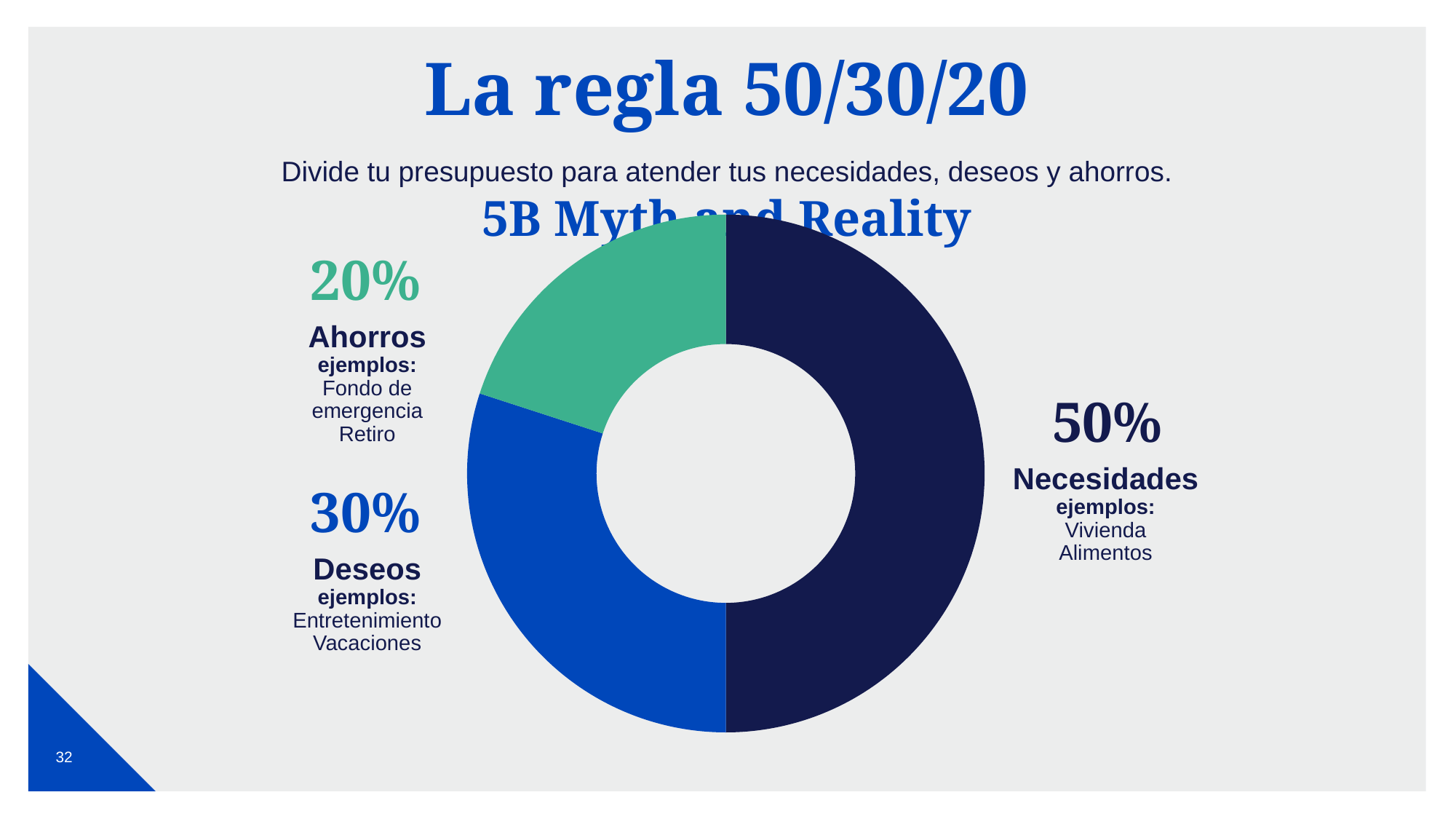
Which category has the smallest share of the chart? Ahorros What is the title of the slide containing the chart? La regla 50/30/20 What share of the budget is allocated to Deseos? 30% What kind of chart is shown on the slide? Donut (pie) chart Which category has the largest share of the chart? Necesidades What share of the budget is allocated to Necesidades? 50% Which is larger, the share for Deseos or the share for Ahorros? Deseos What share of the budget is allocated to Ahorros? 20% What is the difference in percentage points between Necesidades and Ahorros? 30 What colour is the Ahorros segment of the chart? Green How many categories does the chart divide the budget into? 3 What is the difference in percentage points between Deseos and Ahorros? 10